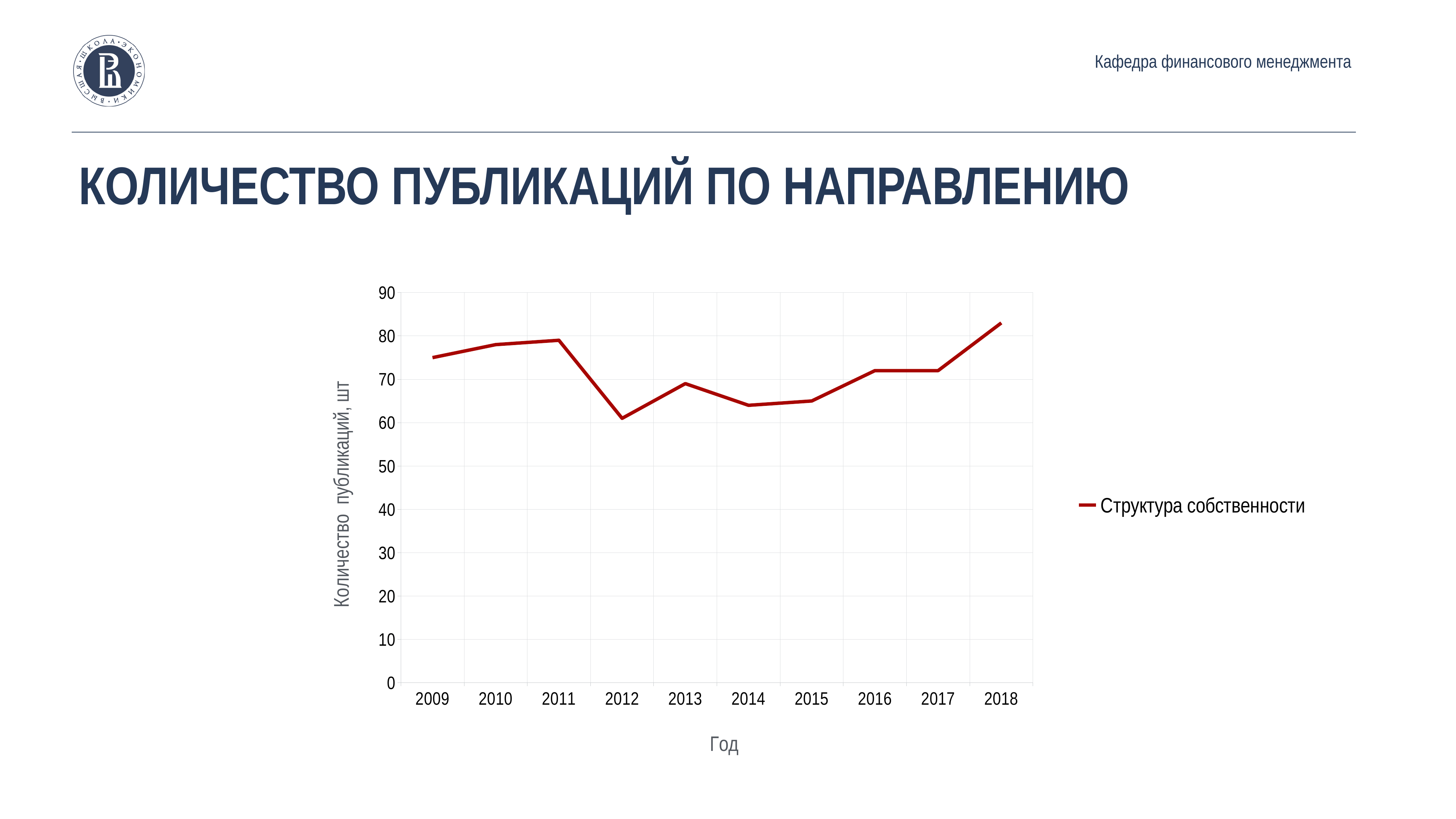
Is the value for 2009 greater or less than 70? greater Which is larger, the value for 2009 or the value for 2012? 2009 Which year has the lowest number of publications? 2012 Is the value for 2015 greater or less than 70? less Is the value for 2012 greater or less than 70? less What kind of chart is shown on the slide? line chart How many series does the legend list? 1 Which year has the highest number of publications? 2018 How many years are plotted along the x axis? 10 What series name is shown in the legend? Структура собственности Do the values rise or fall from 2014 to 2018? rise